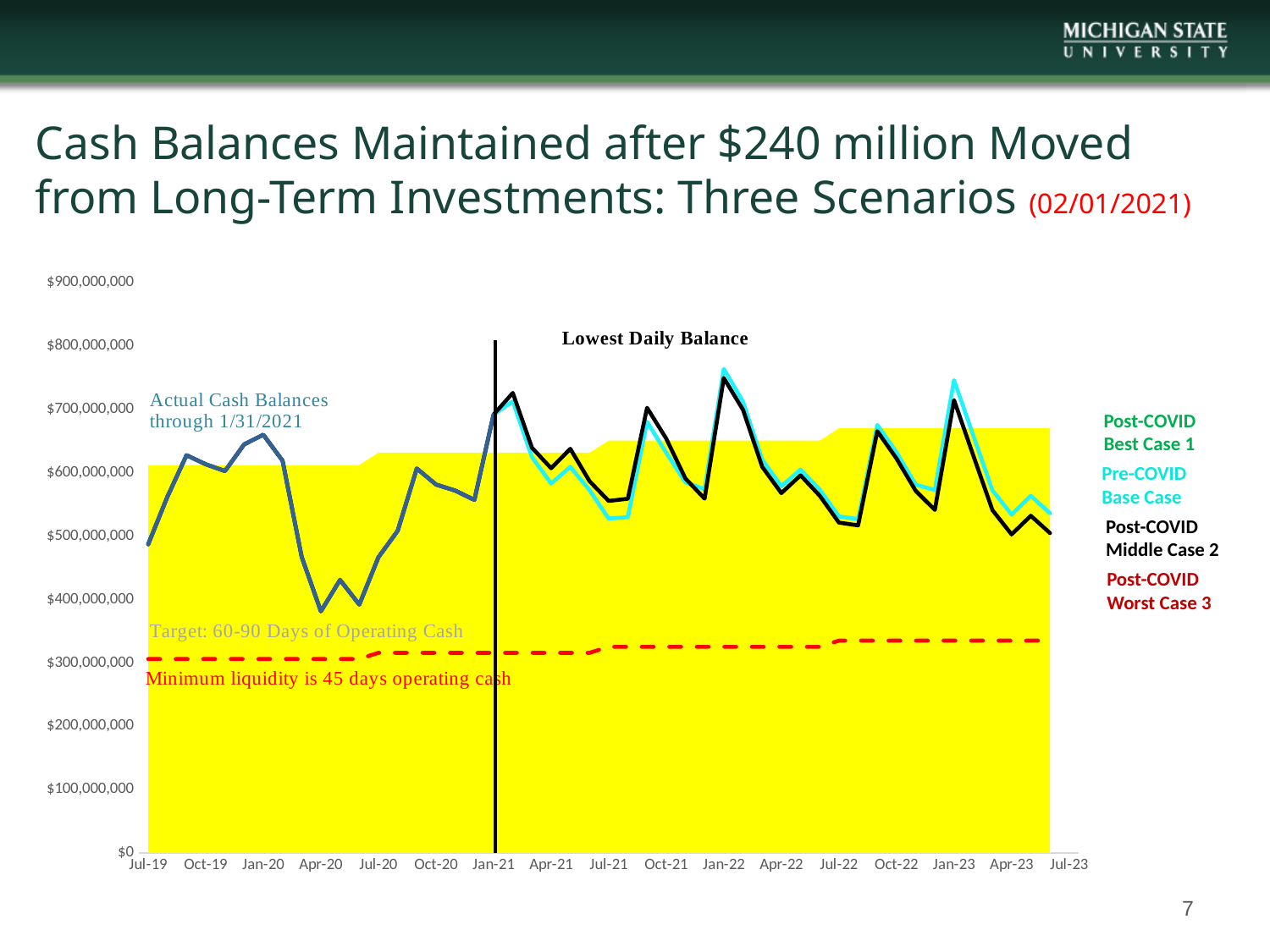
Is the actual cash balance at Apr-20 greater or less than $500,000,000? less What is the highest value shown on the vertical axis of the chart? $900,000,000 Around which x-axis date does the actual cash balance line reach its lowest point? Apr-20 Is the Post-COVID Middle Case 2 value at its Jan-22 peak greater or less than $700,000,000? greater What kind of chart is shown on the slide? line chart How many date labels are shown along the x axis of the chart? 17 What label is written next to the vertical black line at Jan-21 on the chart? Lowest Daily Balance Is the actual cash balance at Jan-20 greater or less than $600,000,000? greater Which is larger, the actual cash balance at Jan-20 or at Apr-20? Jan-20 Does the actual cash balance line rise or fall between Jan-20 and Apr-20? fall How many series does the legend on the right of the chart list? 4